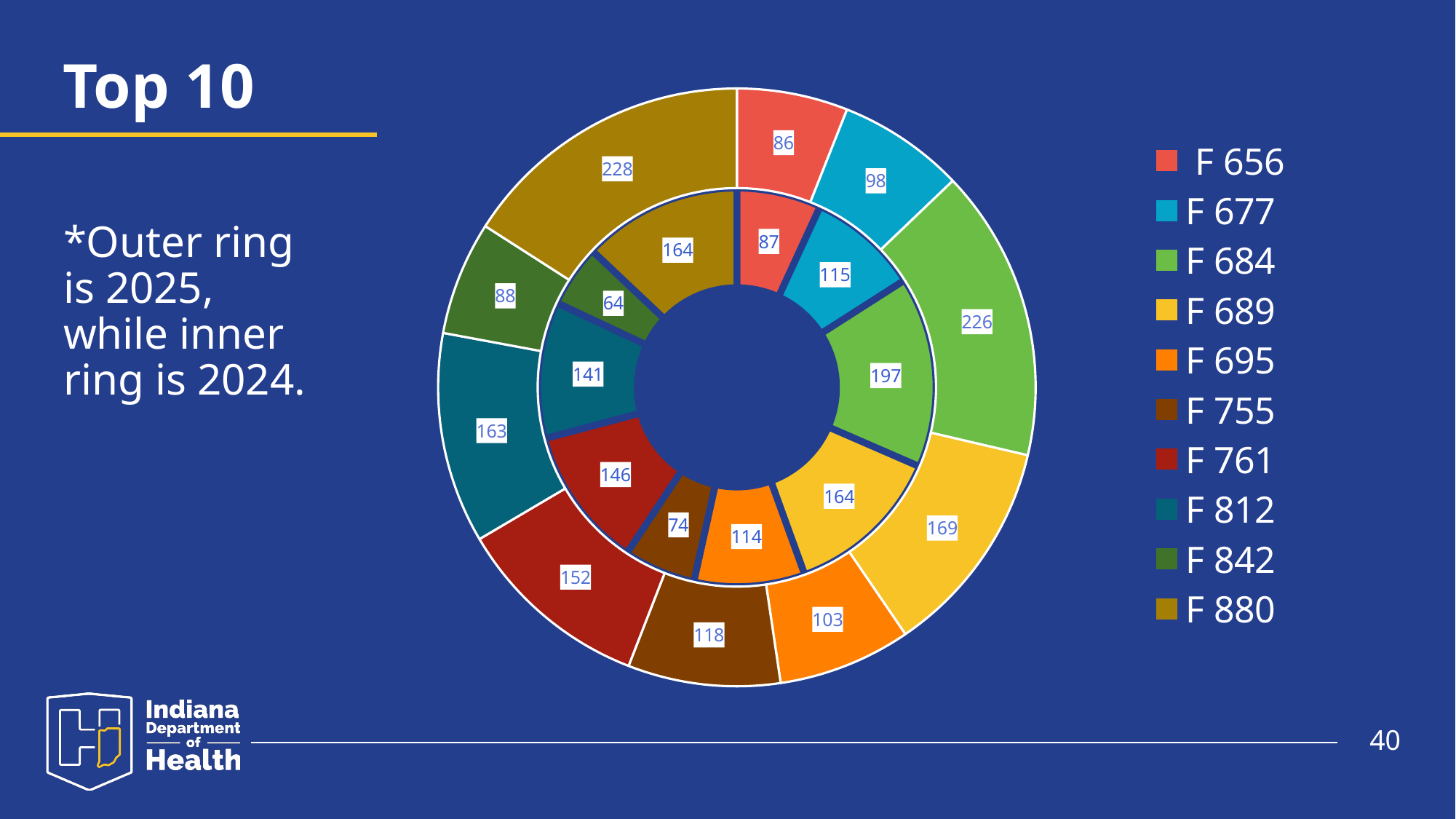
What is the 2024 (inner ring) value for F 755? 74 What is the difference between the 2025 values for F 812 and F 842? 75 Which category has the lowest value in the 2024 inner ring? F 842 What type of chart is shown on the slide? Doughnut chart What is the 2024 (inner ring) value for F 812? 141 According to the slide text, which year does the outer ring represent? 2025 What is the difference between the 2025 and 2024 values for F 880? 64 Which category has the highest value in the 2024 inner ring? F 684 How many categories does the legend list? 10 What is the 2025 (outer ring) value for F 761? 152 What is the 2025 (outer ring) value for F 684? 226 Which is larger for F 695: the 2025 outer ring value or the 2024 inner ring value? 2024 inner ring value